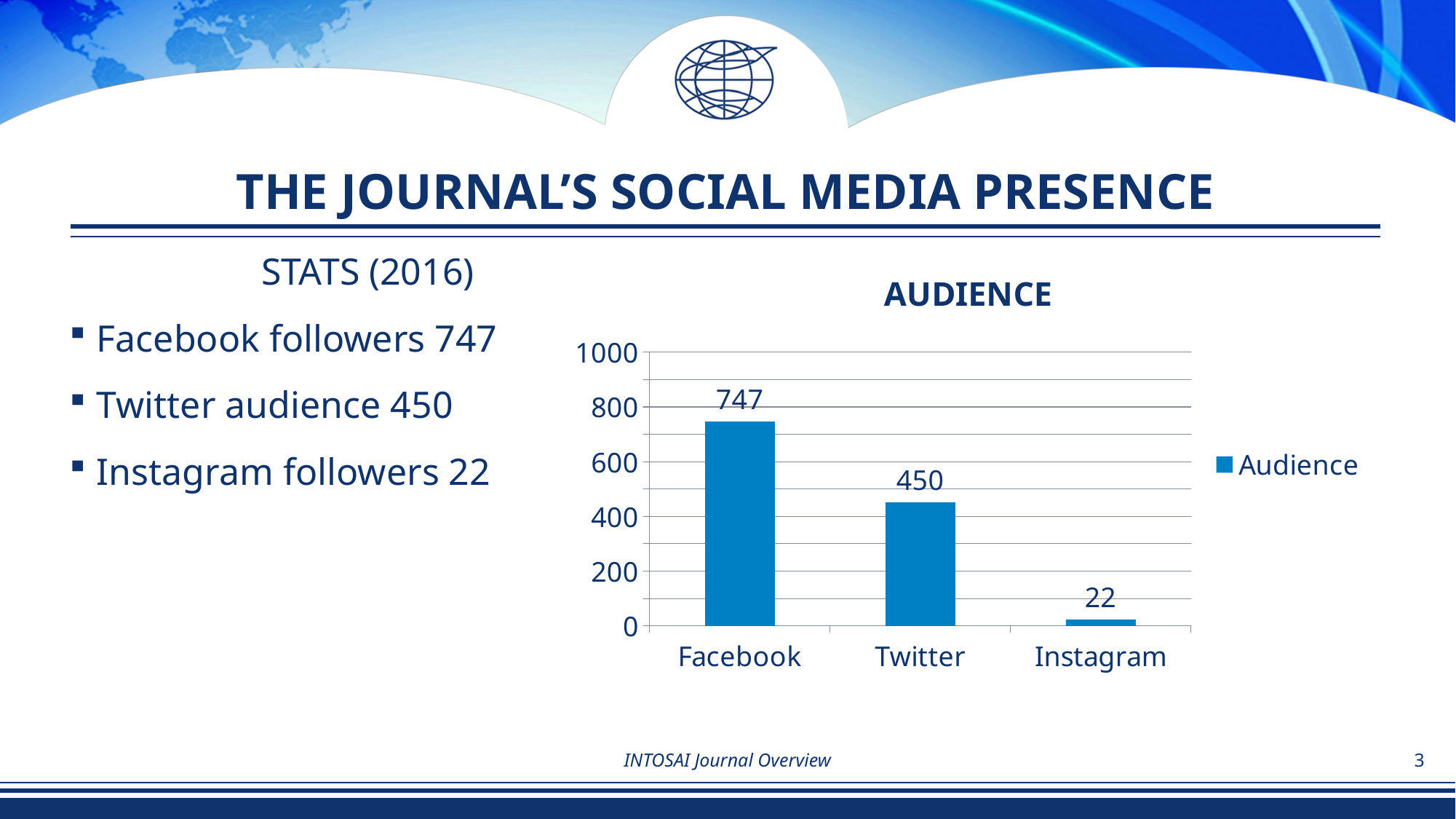
What is the Audience value for Facebook? 747 What is the difference between the Facebook and Twitter Audience values? 297 How many series does the chart legend list? 1 How many platforms are shown on the x axis of the chart? 3 What type of chart is shown on the slide? Bar chart What is the Audience value for Twitter? 450 Which has a larger Audience value, Twitter or Instagram? Twitter What is the difference between the Twitter and Instagram Audience values? 428 Which platform has the highest Audience value? Facebook What is the Audience value for Instagram? 22 Which platform has the lowest Audience value? Instagram Is the Audience value for Facebook greater or less than 600? greater